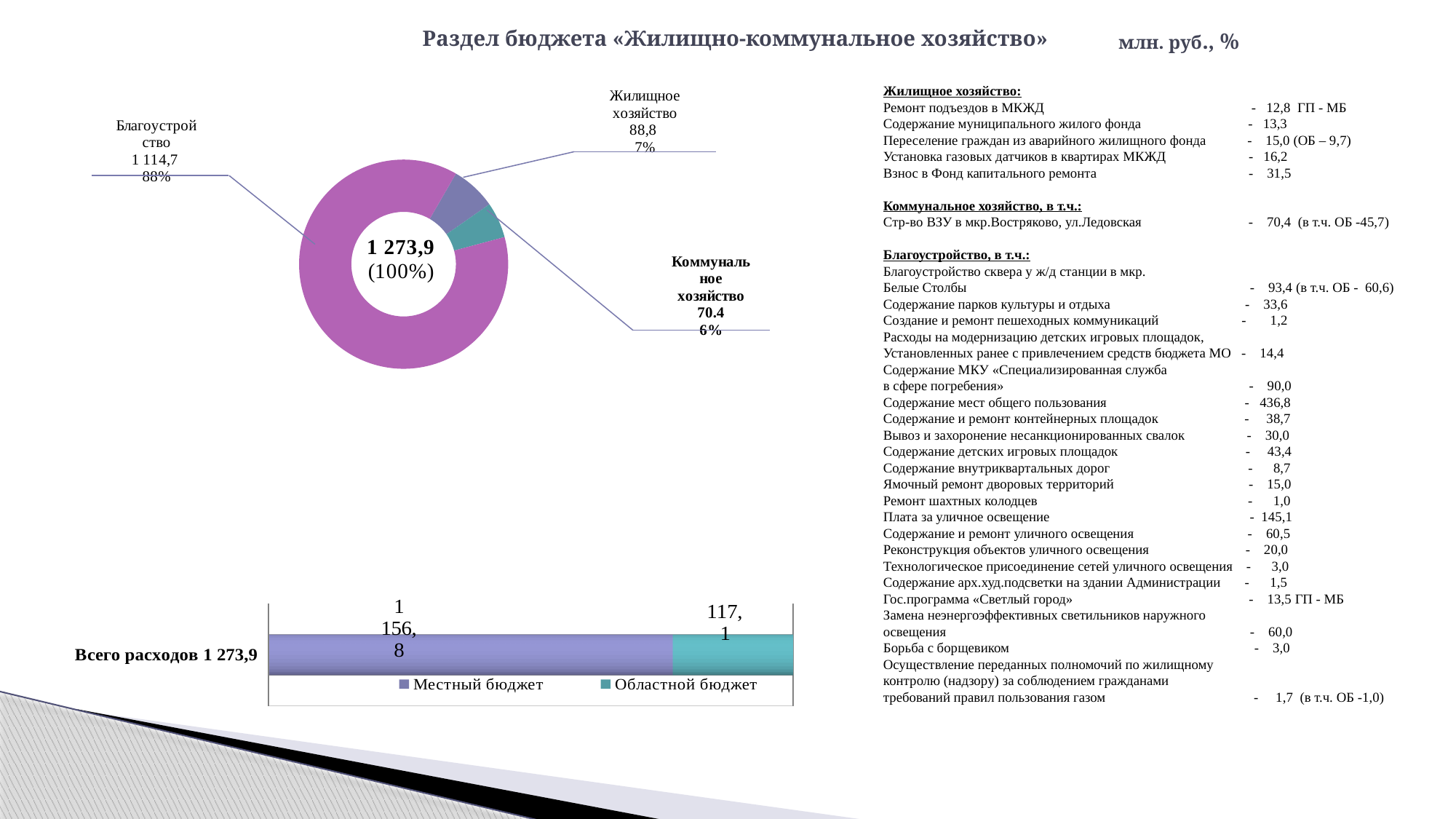
In the donut chart at the top left, what value is shown for Коммунальное хозяйство? 70.4 In the donut chart at the top left, how many slices are there? 3 In the donut chart at the top left, what is the difference between the values for Жилищное хозяйство and Коммунальное хозяйство? 18,4 In the bar chart at the bottom, what value is shown for Областной бюджет? 117,1 In the donut chart at the top left, what share of the total does Жилищное хозяйство have? 7% In the donut chart at the top left, which category has the smallest slice? Коммунальное хозяйство In the bar chart at the bottom, how many series does the legend list? 2 In the bar chart at the bottom, what value is shown for Местный бюджет? 1 156,8 What kind of chart is shown at the bottom of the slide? Stacked bar chart In the donut chart at the top left, which category has the largest slice? Благоустройство In the donut chart at the top left, what total is shown in the centre of the ring? 1 273,9 (100%) In the donut chart at the top left, what value is shown for Благоустройство? 1 114,7